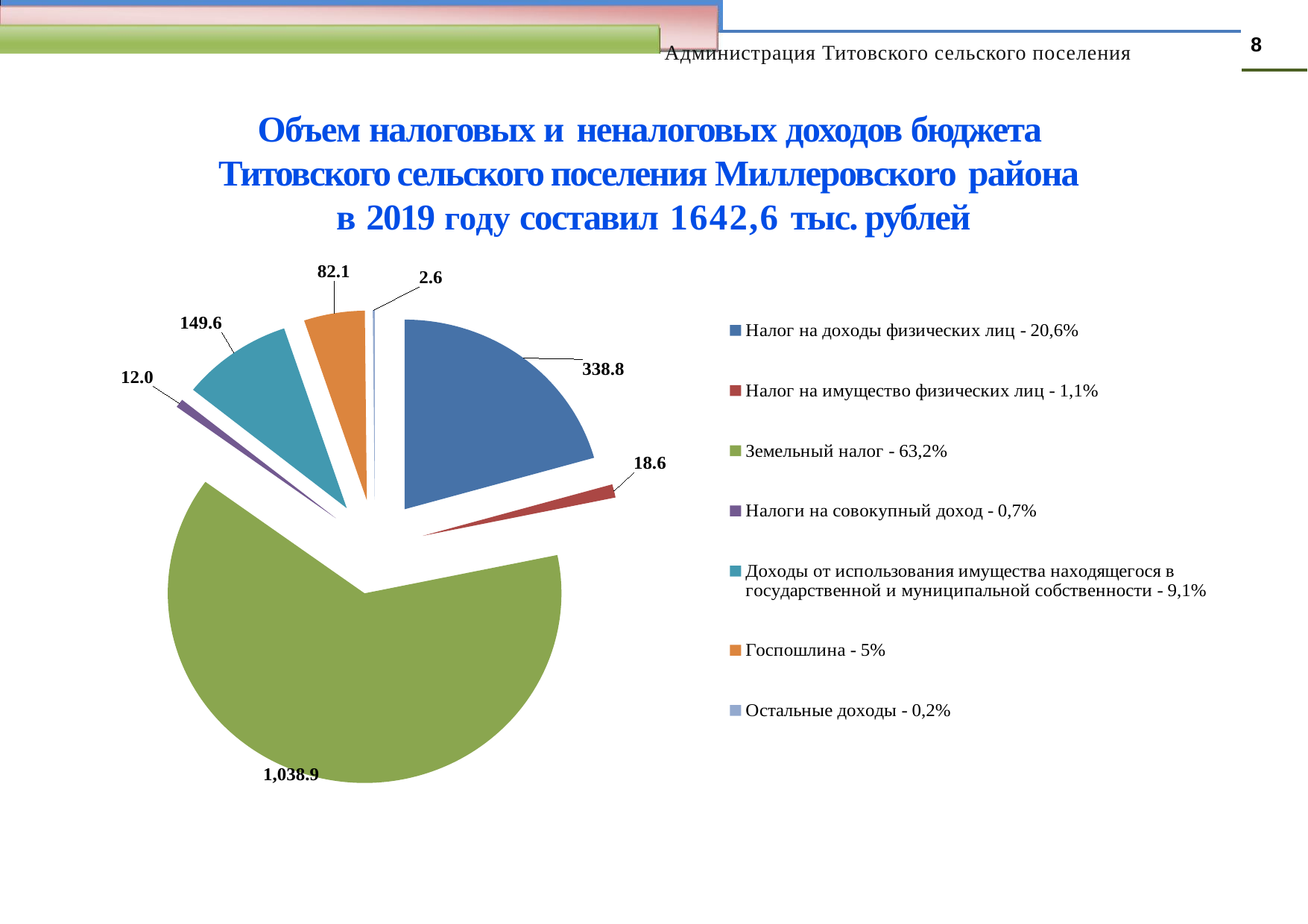
What is the value of the slice for Остальные доходы? 2.6 What type of chart is shown on the slide? pie chart What is the value of the slice for Земельный налог? 1,038.9 What colour is the slice for Земельный налог? green Which category has the smallest slice in the pie chart? Остальные доходы What is the difference between the values for Налог на доходы физических лиц and Доходы от использования имущества находящегося в государственной и муниципальной собственности? 189.2 Which category has the largest slice in the pie chart? Земельный налог What is the value of the slice for Налог на доходы физических лиц? 338.8 What share of the pie does Налог на доходы физических лиц represent, according to the legend? 20,6% How many slices does the pie chart have? 7 What is the value of the slice for Госпошлина? 82.1 Which is larger: the value for Госпошлина or the value for Налог на имущество физических лиц? Госпошлина